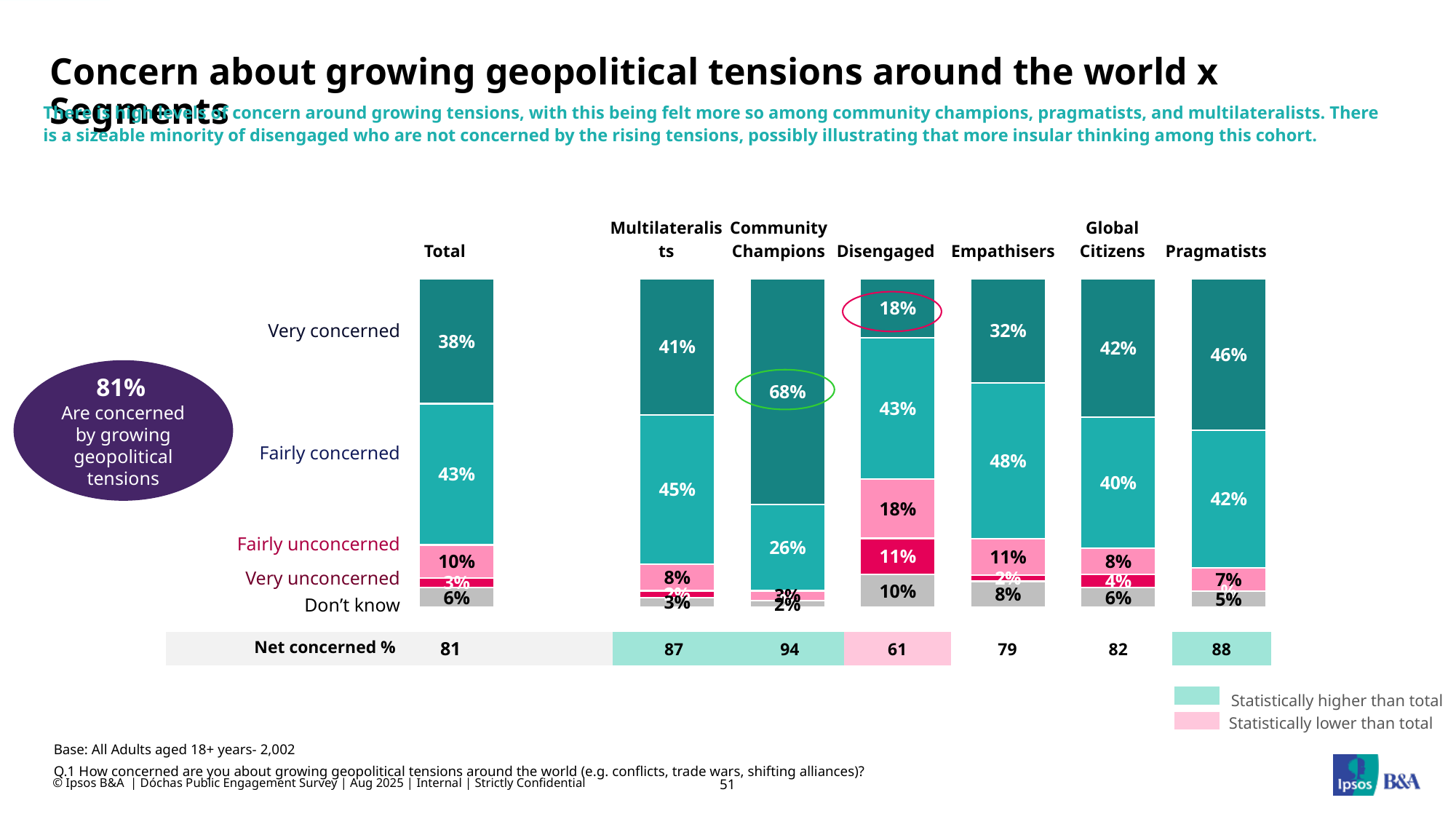
Which has a larger fairly concerned share: Multilateralists or Global Citizens? Multilateralists What is the Net concerned % for the Disengaged segment? 61 What percentage of Pragmatists are very concerned about growing geopolitical tensions? 46% What type of chart is used on this slide? Stacked bar chart What percentage of Empathisers are fairly concerned? 48% How many response categories are stacked in each bar? 5 How many segment bars (including Total) are shown in the chart? 7 What percentage of the Disengaged segment are fairly unconcerned? 18% Which segment has the highest Net concerned %? Community Champions Which segment has the lowest share of people who are very concerned? Disengaged Which segment has the highest share of people who are very concerned? Community Champions How many percentage points higher is the very concerned share for Community Champions than for Total? 30 percentage points